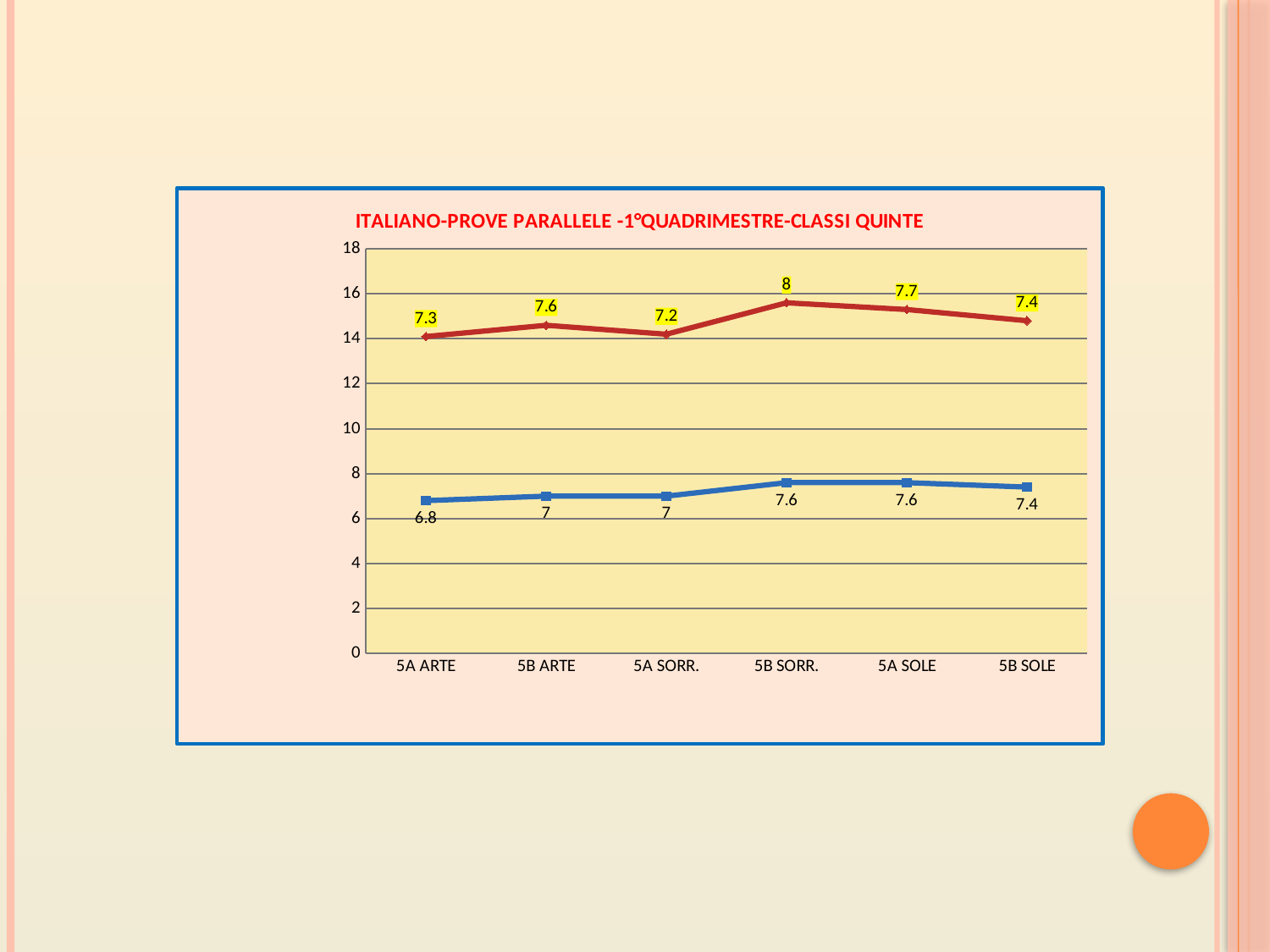
Which category has the lowest data label on the blue line? 5A ARTE Is the blue line's point for 5B SORR. plotted above or below 8 on the y axis? below Which has the larger data label on the red line, 5B ARTE or 5A SORR.? 5B ARTE What is the data label of the blue line for 5A ARTE? 6.8 What is the title of the chart? ITALIANO-PROVE PARALLELE -1°QUADRIMESTRE-CLASSI QUINTE What is the data label of the red line for 5A SOLE? 7.7 What is the data label of the blue line for 5B SOLE? 7.4 Which category has the highest data label on the red line? 5B SORR. What is the difference between the red line's data labels for 5B SORR. and 5A SORR.? 0.8 How many categories are shown on the x axis? 6 What is the data label of the red line for 5B SORR.? 8 What kind of chart is shown on the slide? line chart